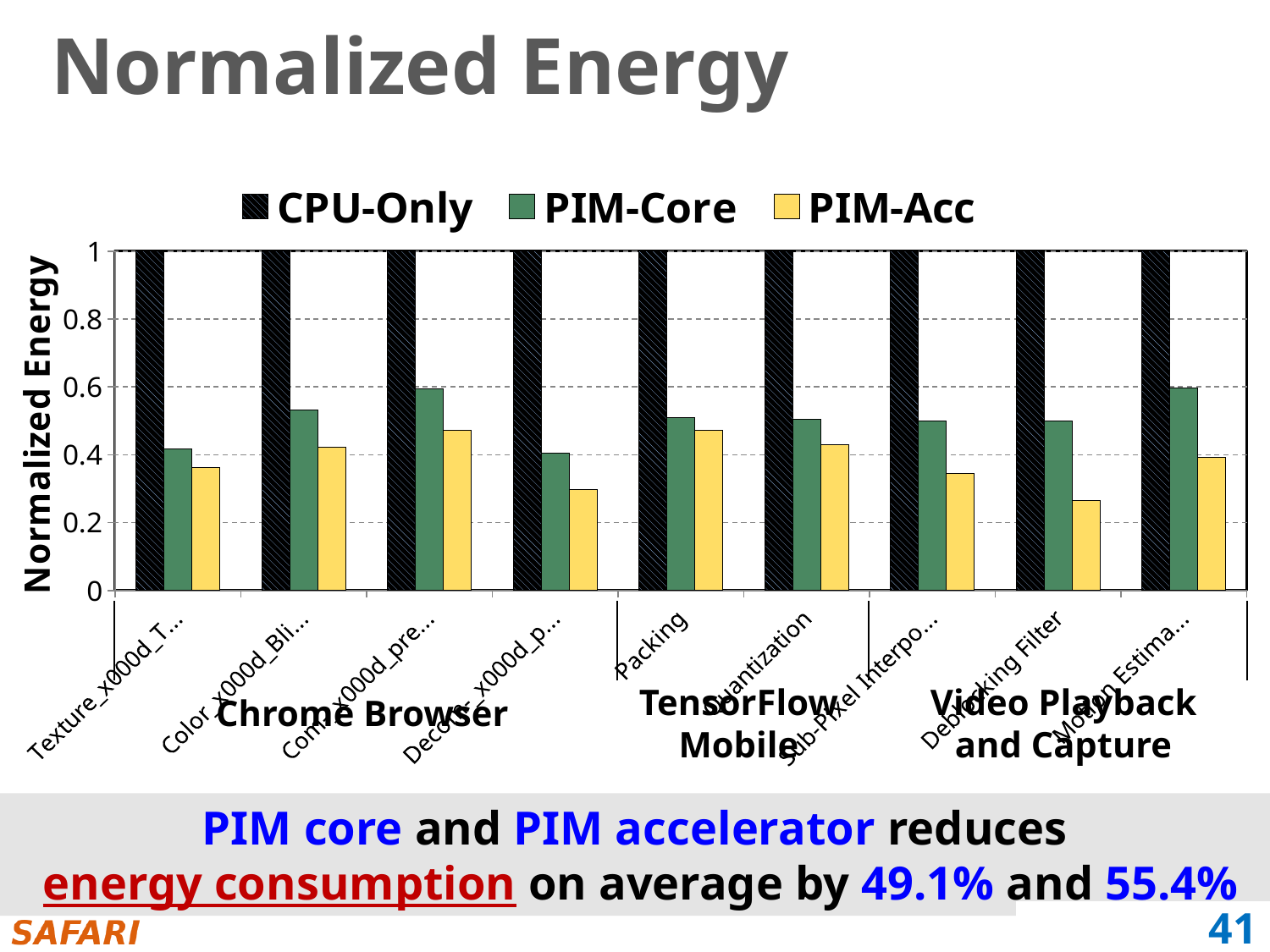
What is the CPU-Only value for Deblocking Filter? 1 For Deblocking Filter, which is larger: the PIM-Core value or the PIM-Acc value? PIM-Core Is the PIM-Core value for Quantization greater or less than 0.6? less How many series does the legend list? 3 What kind of chart is shown on the slide? bar chart How many categories (groups of bars) are plotted on the x axis? 9 What is the CPU-Only value for Packing? 1 Which series has the highest value in every category? CPU-Only What are the three series named in the legend? CPU-Only, PIM-Core, PIM-Acc Is the PIM-Acc value for Packing greater or less than 0.4? greater What is the y-axis title of the chart? Normalized Energy Is the PIM-Acc value for Deblocking Filter greater or less than 0.4? less